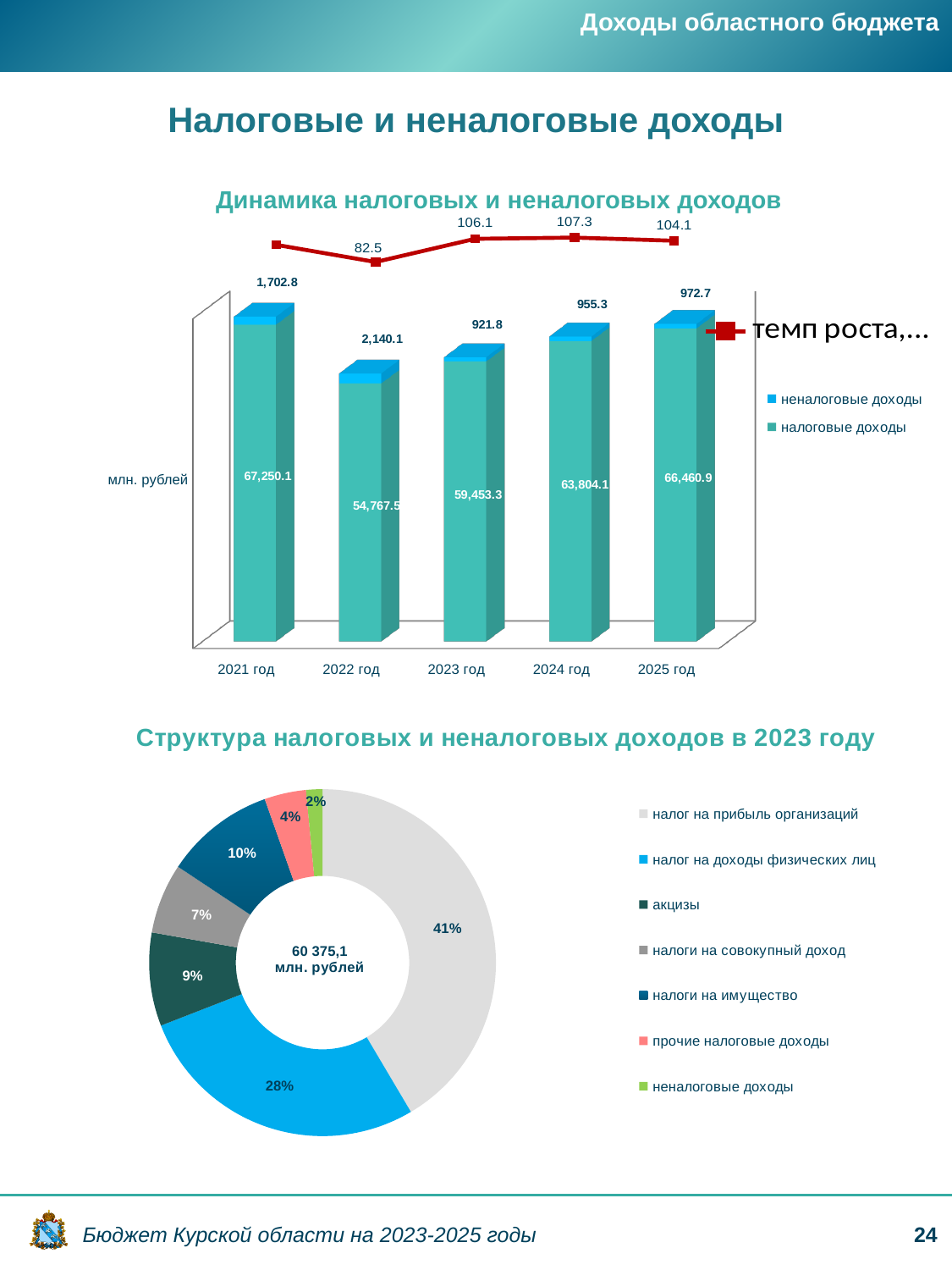
In the chart 'Структура налоговых и неналоговых доходов в 2023 году', which category has the largest share? налог на прибыль организаций In the chart 'Динамика налоговых и неналоговых доходов', is неналоговые доходы larger in 2021 год or 2022 год? 2022 год In the chart 'Динамика налоговых и неналоговых доходов', which year has the lowest value of неналоговые доходы? 2023 год In the chart 'Динамика налоговых и неналоговых доходов', how many years are shown on the x axis? 5 In the chart 'Динамика налоговых и неналоговых доходов', which year has the highest value of налоговые доходы? 2021 год In the chart 'Динамика налоговых и неналоговых доходов', what is the темп роста value shown for 2023 год? 106.1 In the chart 'Динамика налоговых и неналоговых доходов', what is the difference between налоговые доходы in 2025 год and 2024 год? 2,656.8 In the chart 'Динамика налоговых и неналоговых доходов', what is the value of неналоговые доходы for 2025 год? 972.7 In the chart 'Динамика налоговых и неналоговых доходов', what is the value of налоговые доходы for 2022 год? 54,767.5 In the chart 'Структура налоговых и неналоговых доходов в 2023 году', how many categories does the legend list? 7 In the chart 'Структура налоговых и неналоговых доходов в 2023 году', what share does налог на доходы физических лиц have? 28% In the chart 'Динамика налоговых и неналоговых доходов', what is the total of the stacked bar for 2023 год? 60,375.1